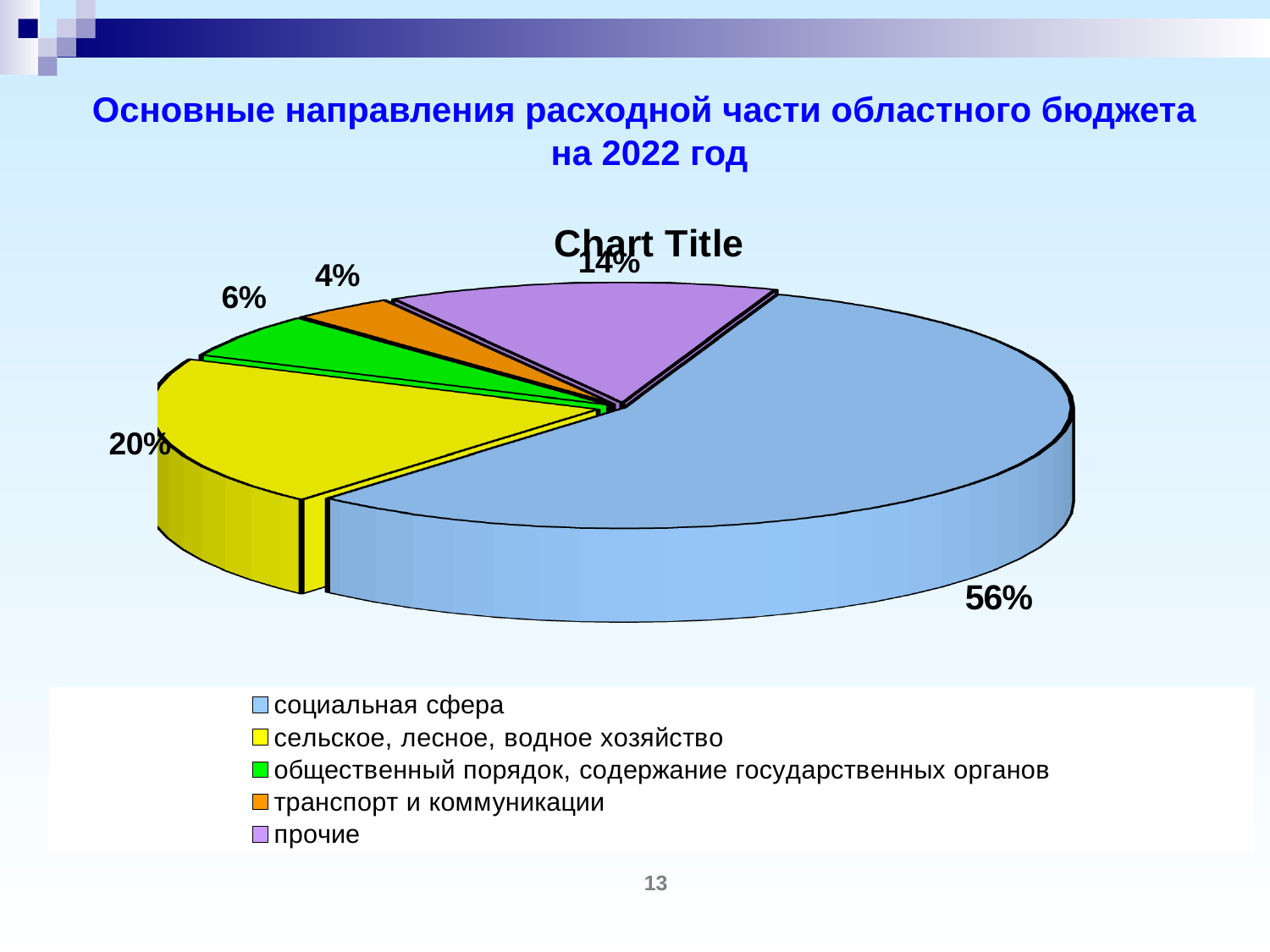
What is the difference between the shares of социальная сфера and сельское, лесное, водное хозяйство? 36% Which category has the smallest slice of the pie? транспорт и коммуникации What kind of chart is shown on the slide? pie chart What share of the pie does общественный порядок, содержание государственных органов have? 6% What colour is the slice for сельское, лесное, водное хозяйство? yellow Which category has the largest slice of the pie? социальная сфера Which is larger, the share of прочие or the share of общественный порядок, содержание государственных органов? прочие What share of the pie does прочие have? 14% How many categories does the pie chart show? 5 What share of the pie does сельское, лесное, водное хозяйство have? 20%